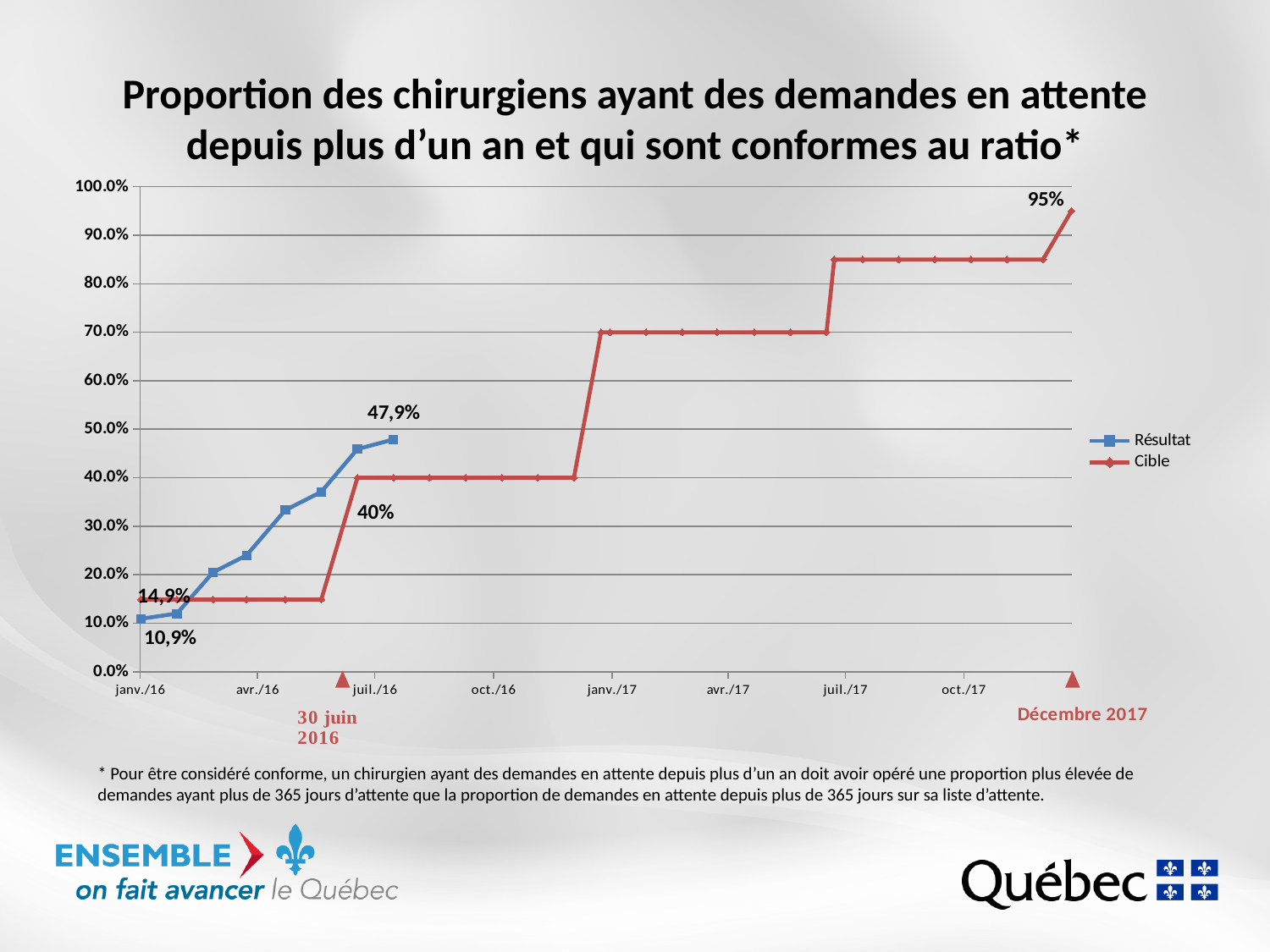
What is the Cible value set for 30 juin 2016? 40% How many series does the legend list? 2 What is the Cible value for Décembre 2017? 95% What are the two series named in the legend? Résultat and Cible What is the Cible value at janv./16? 14,9% What is the Résultat value at janv./16? 10,9% What is the difference between the Cible for Décembre 2017 and the Cible for 30 juin 2016? 55% What is the latest labelled Résultat value? 47,9% What kind of chart is shown on the slide? line chart At janv./16, which is higher: Résultat or Cible? Cible What is the difference between the latest Résultat value (47,9%) and the Résultat value at janv./16 (10,9%)? 37% Is the Cible value at oct./17 greater or less than 80%? greater